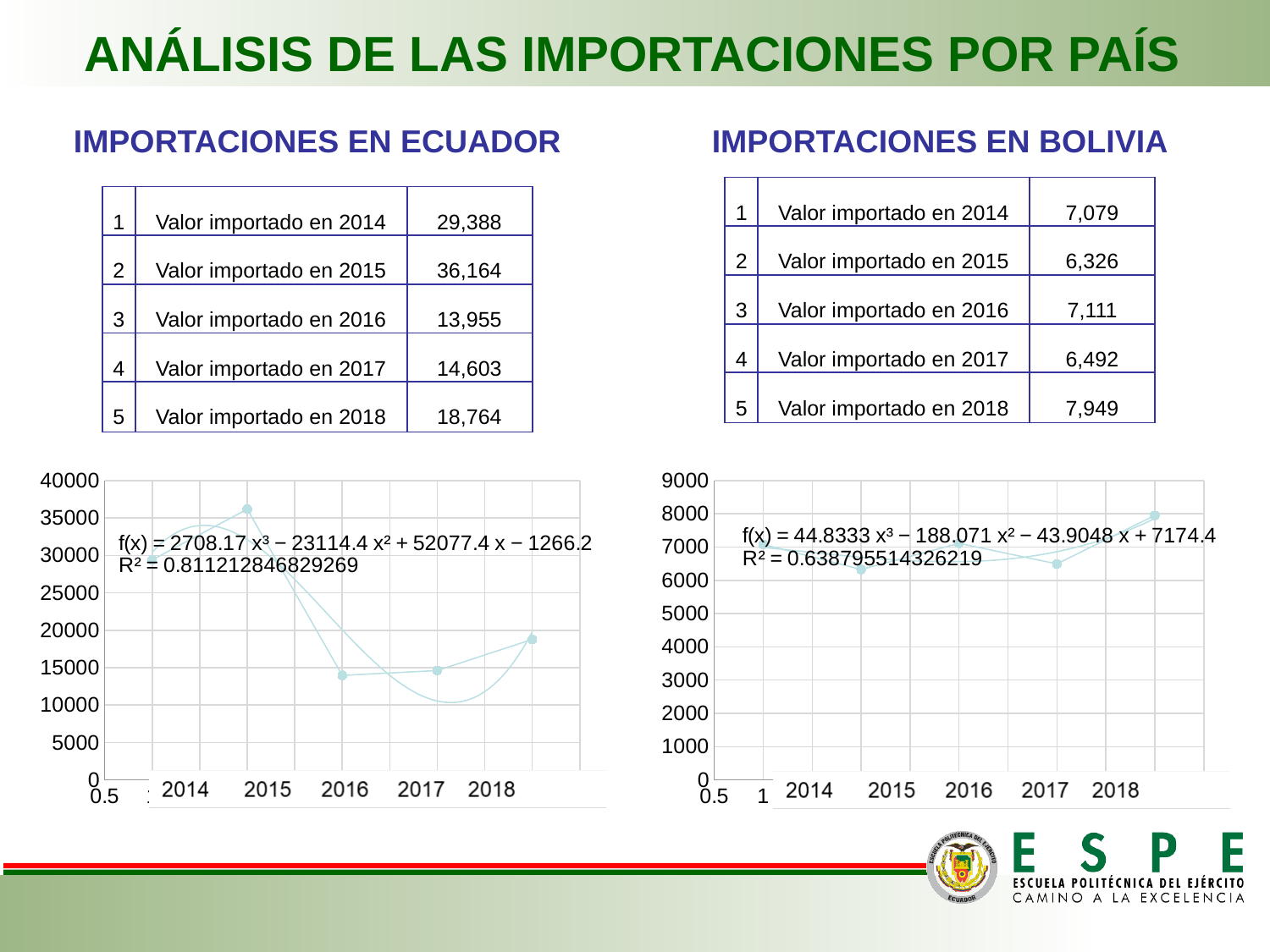
On the Importaciones en Ecuador chart, do the values rise or fall from 2016 to 2018? rise On the Importaciones en Ecuador chart, which year has the lowest imported value? 2016 On the Importaciones en Ecuador chart, is the value for 2016 greater or less than 15000? less On the Importaciones en Ecuador chart, which year has the highest imported value? 2015 On the Importaciones en Ecuador chart, is the value for 2015 greater or less than 35000? greater On the Importaciones en Bolivia chart, is the value for 2018 greater or less than 7000? greater On the Importaciones en Ecuador chart, how many data points are plotted? 5 On the Importaciones en Bolivia chart, which year has the highest imported value? 2018 What is the maximum value shown on the vertical axis of the Importaciones en Ecuador chart? 40000 What is the R² value shown on the Importaciones en Bolivia chart? 0.638795514326219 On the Importaciones en Bolivia chart, which is larger, the value for 2014 or the value for 2018? 2018